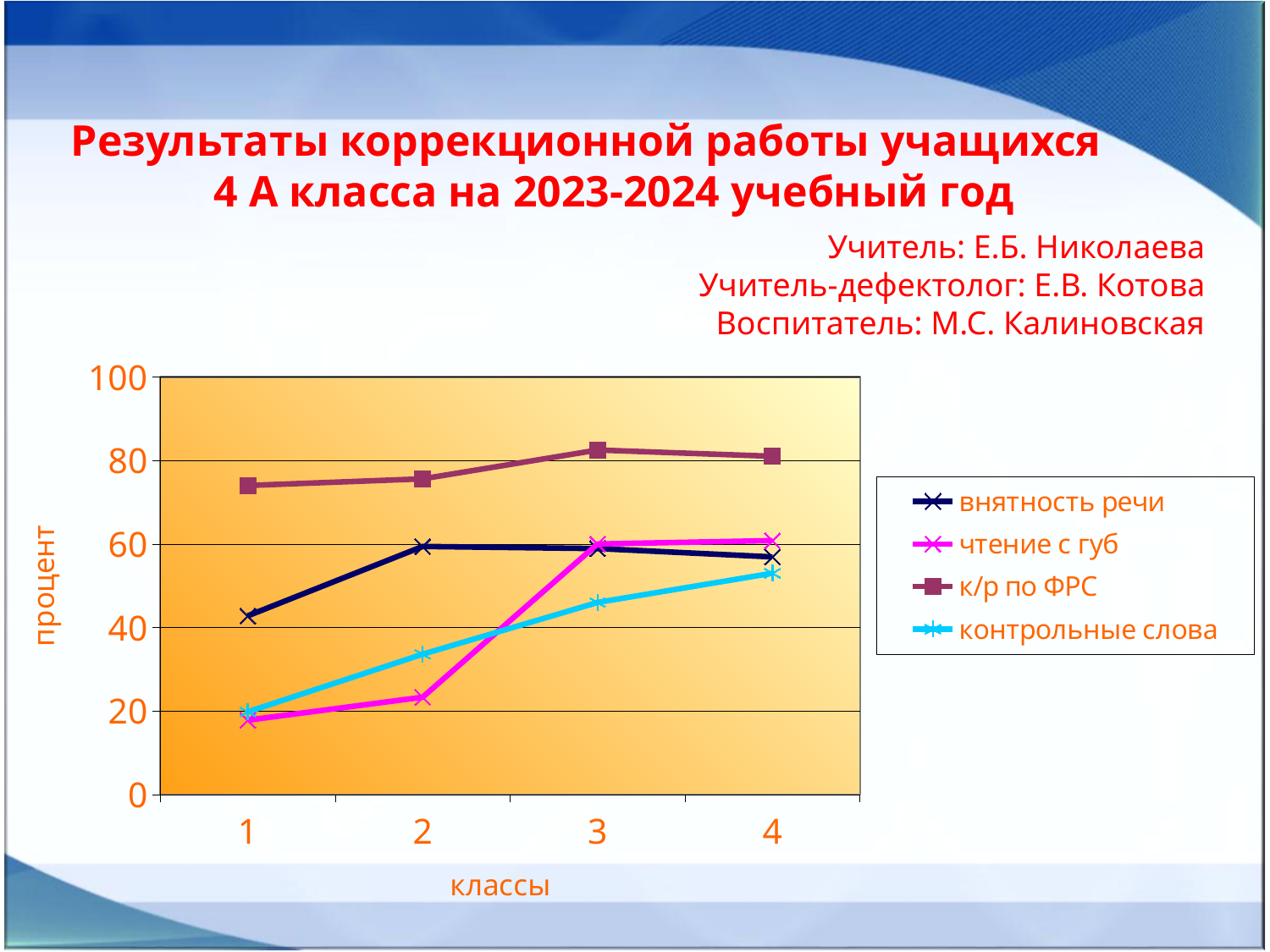
Is the value for к/р по ФРС at class 1 greater or less than 60? greater At class 2, which is larger: внятность речи or контрольные слова? внятность речи Is the value for контрольные слова at class 4 greater or less than 60? less What is the label of the vertical axis? процент Is the value for внятность речи at class 1 greater or less than 60? less Which series has the highest value at class 3? к/р по ФРС Which series has the lowest value at class 2? чтение с губ Do the values for контрольные слова rise or fall from class 1 to class 4? rise How many series does the legend list? 4 How many classes (points) are plotted along the x axis? 4 What kind of chart is shown on the slide? line chart